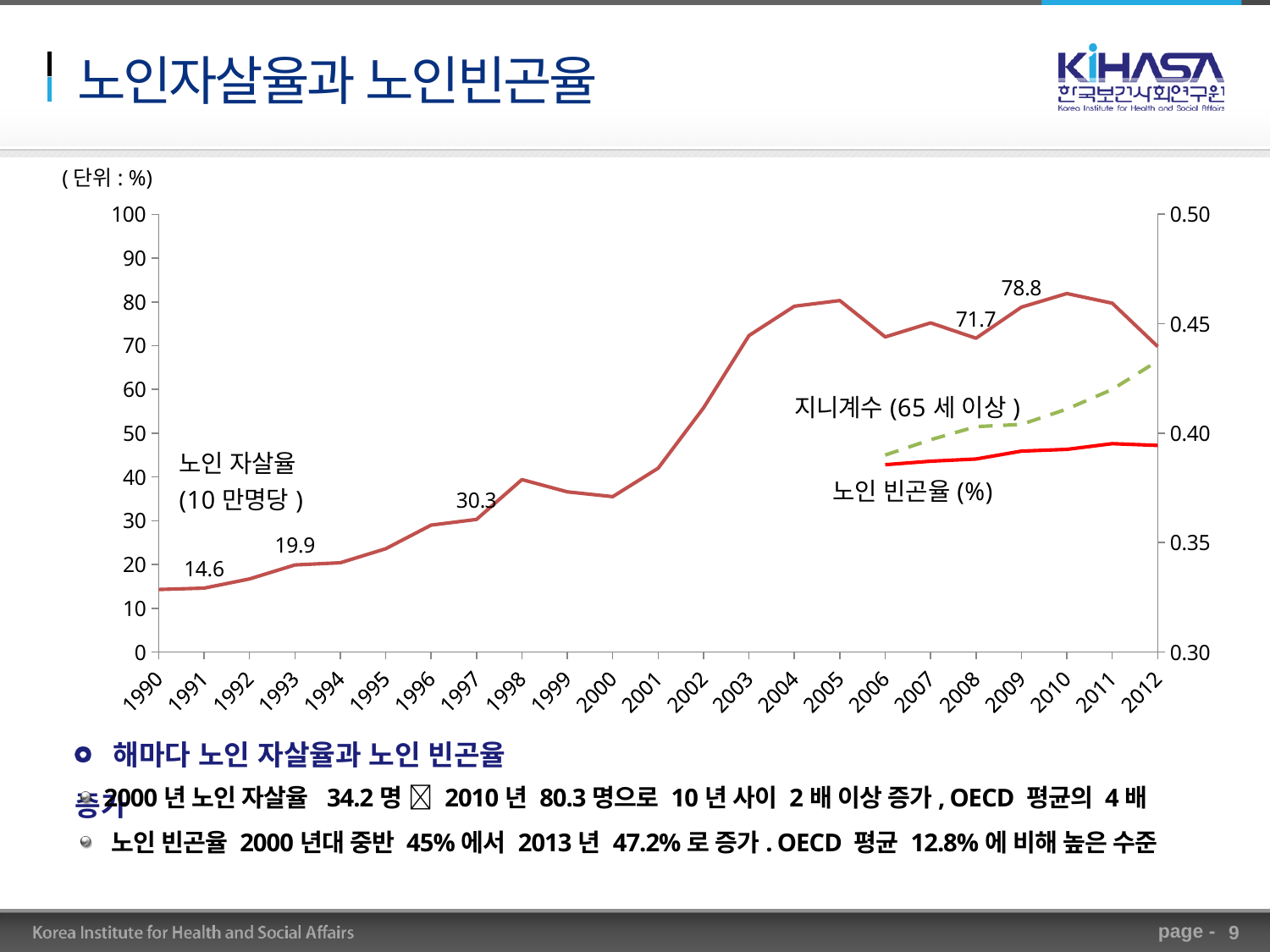
What is the difference between the labeled elderly suicide rate values for 2009 and 2008? 7.1 What is the elderly suicide rate (노인 자살율) value labeled for 1993? 19.9 How many years are shown on the x axis of the chart? 23 What is the elderly suicide rate (노인 자살율) value labeled for 2008? 71.7 What kind of chart is shown on the slide? line chart What is the elderly suicide rate (노인 자살율) value labeled for 2009? 78.8 Which year has the higher labeled elderly suicide rate, 1993 or 1997? 1997 Does the Gini coefficient (지니계수) line rise or fall from 2006 to 2012? rise What is the elderly suicide rate (노인 자살율) value labeled for 1997? 30.3 Is the elderly suicide rate (노인 자살율) for 2004 greater or less than 70? greater